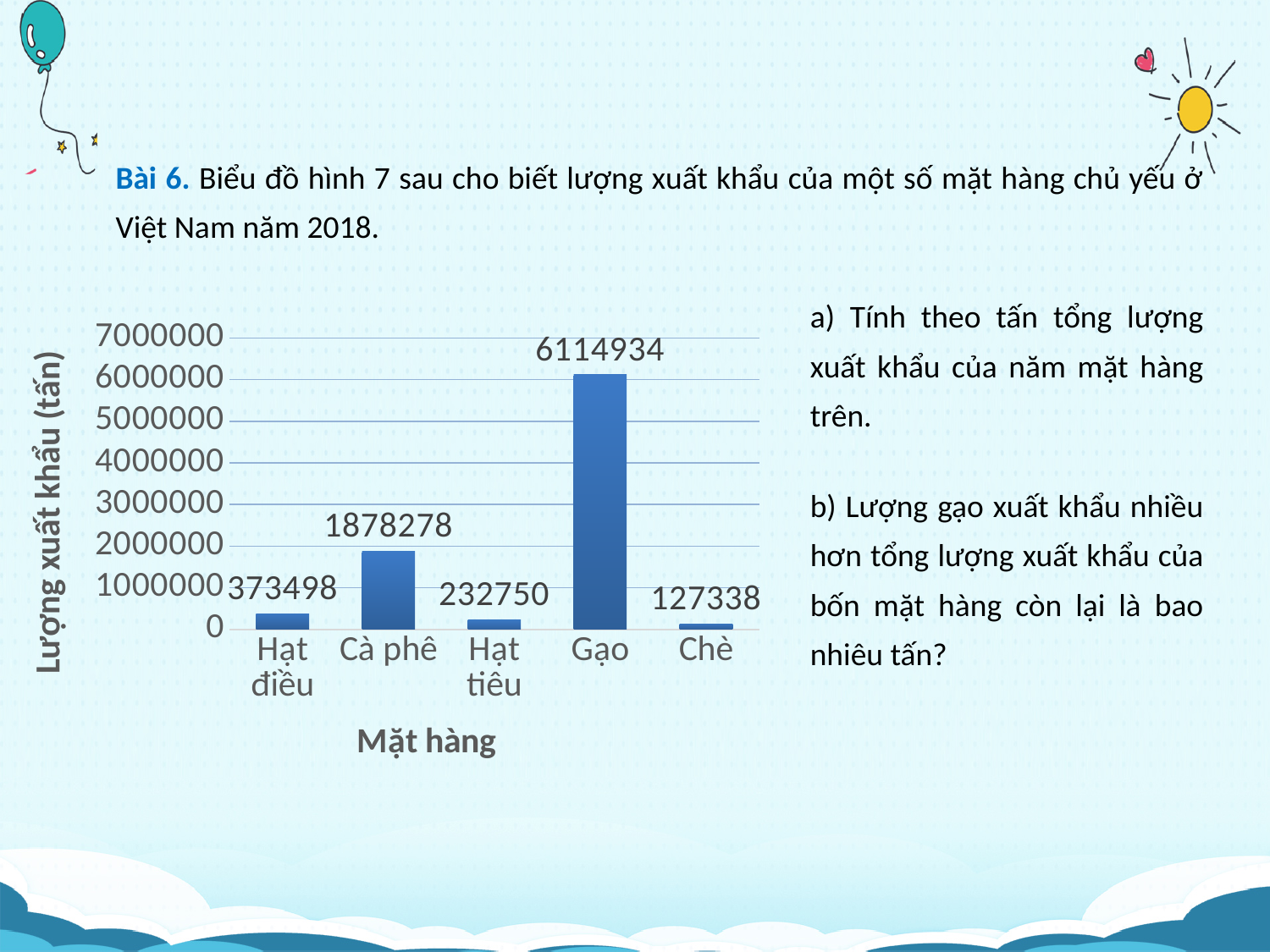
How many products are shown on the chart? 5 What is the export volume shown for Cà phê? 1878278 Which product has the lowest export volume? Chè Which product has the highest export volume? Gạo What kind of chart is shown on the slide? bar chart Is the value for Cà phê greater or less than 1000000? greater What is the difference between the export volumes of Gạo and Cà phê? 4236656 What is the export volume shown for Chè? 127338 What is the difference between the export volumes of Hạt điều and Hạt tiêu? 140748 What is the export volume shown for Gạo? 6114934 What is the label of the vertical axis? Lượng xuất khẩu (tấn) Which has a larger export volume, Hạt điều or Hạt tiêu? Hạt điều